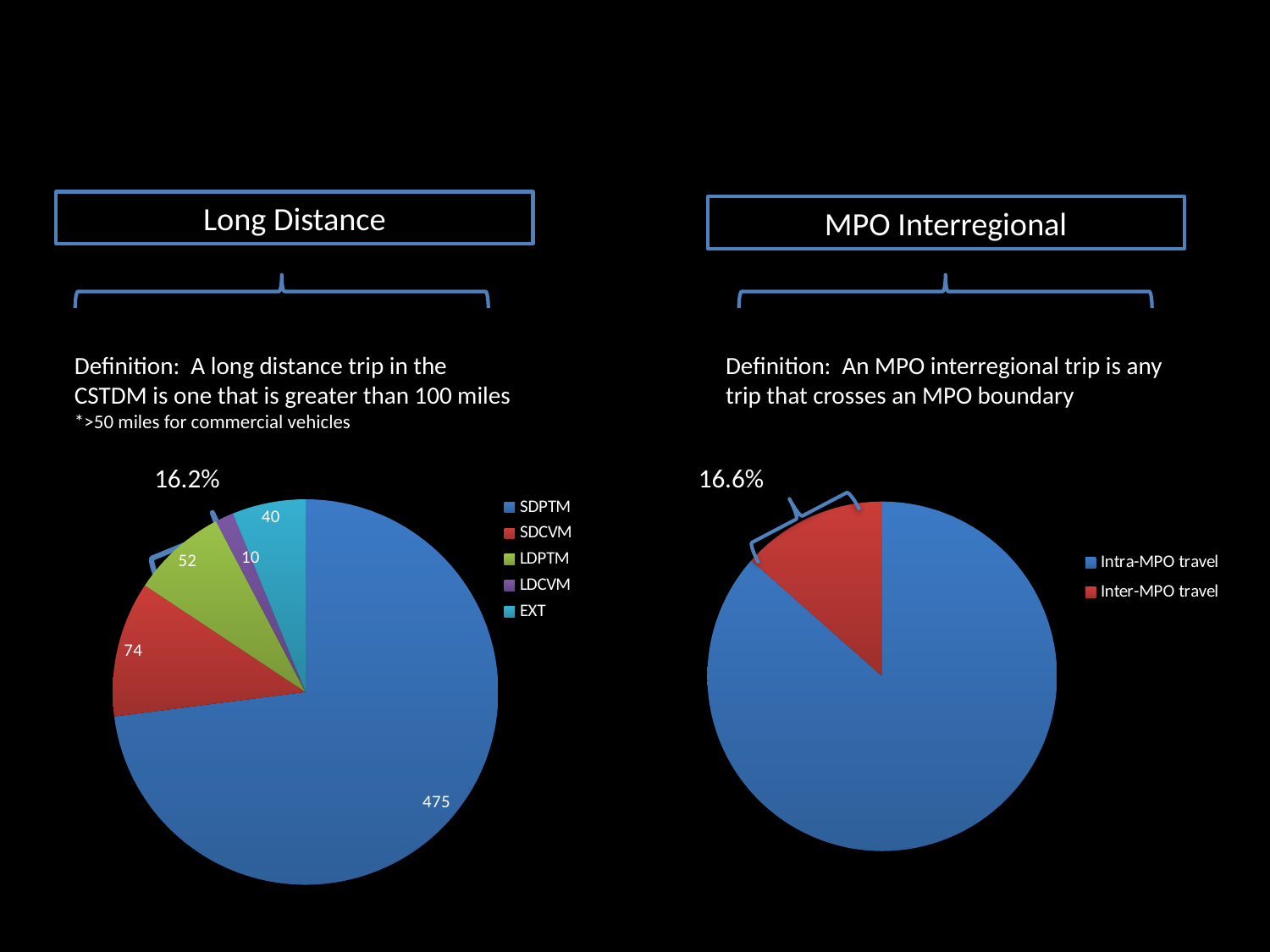
In the Long Distance chart, what is the difference between the SDCVM value and the LDPTM value? 22 How many categories does the legend of the Long Distance chart list? 5 In the Long Distance chart, what is the value for EXT? 40 In the Long Distance chart, which category has the smallest slice? LDCVM In the Long Distance chart, which category has the largest slice? SDPTM In the Long Distance chart, which is larger, EXT or LDPTM? LDPTM What percentage is annotated next to the MPO Interregional chart on the right? 16.6% In the Long Distance chart, what is the value for SDCVM? 74 In the Long Distance chart, what is the value for SDPTM? 475 What kind of chart is the Long Distance chart on the left? pie chart In the Long Distance chart, what is the value for LDPTM? 52 In the MPO Interregional chart on the right, which category has the larger slice? Intra-MPO travel